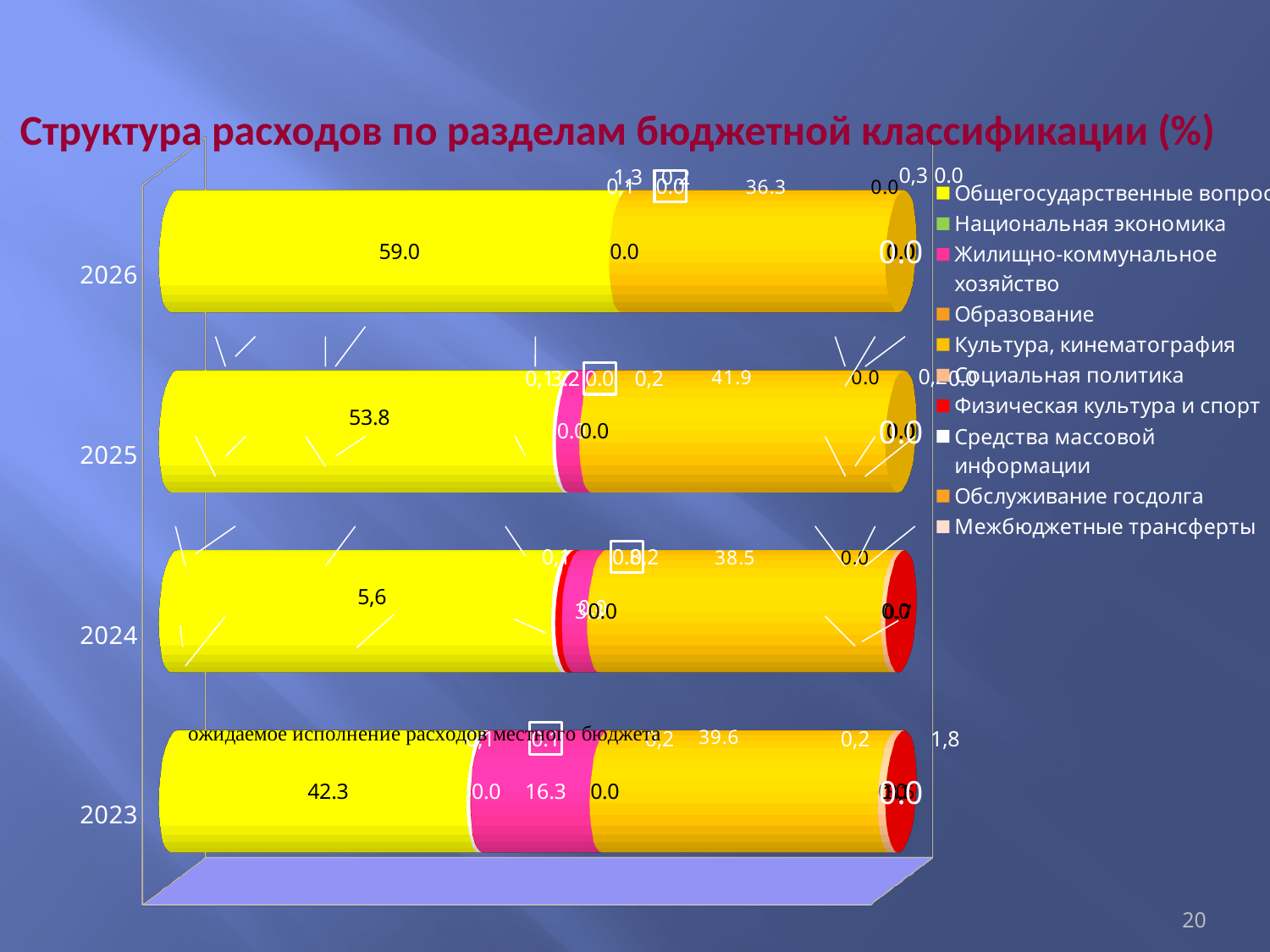
Which is larger, the Общегосударственные вопросы value for 2026 or for 2025? 2026 What is the value of the yellow segment (Общегосударственные вопросы) for 2026? 59.0 What is the title of the chart on the slide? Структура расходов по разделам бюджетной классификации (%) What is the value of the pink segment (Жилищно-коммунальное хозяйство) for 2023? 16.3 How many series does the chart legend list? 10 What kind of chart is shown on the slide? Stacked bar chart What is the value printed on the large orange segment for 2025? 41.9 What is the value printed on the large orange segment for 2026? 36.3 What is the difference between the Общегосударственные вопросы values for 2026 and 2025? 5.2 What is the value of the yellow segment (Общегосударственные вопросы) for 2025? 53.8 How many years (categories) are shown on the vertical axis of the chart? 4 What is the value of the yellow segment (Общегосударственные вопросы) for 2023? 42.3